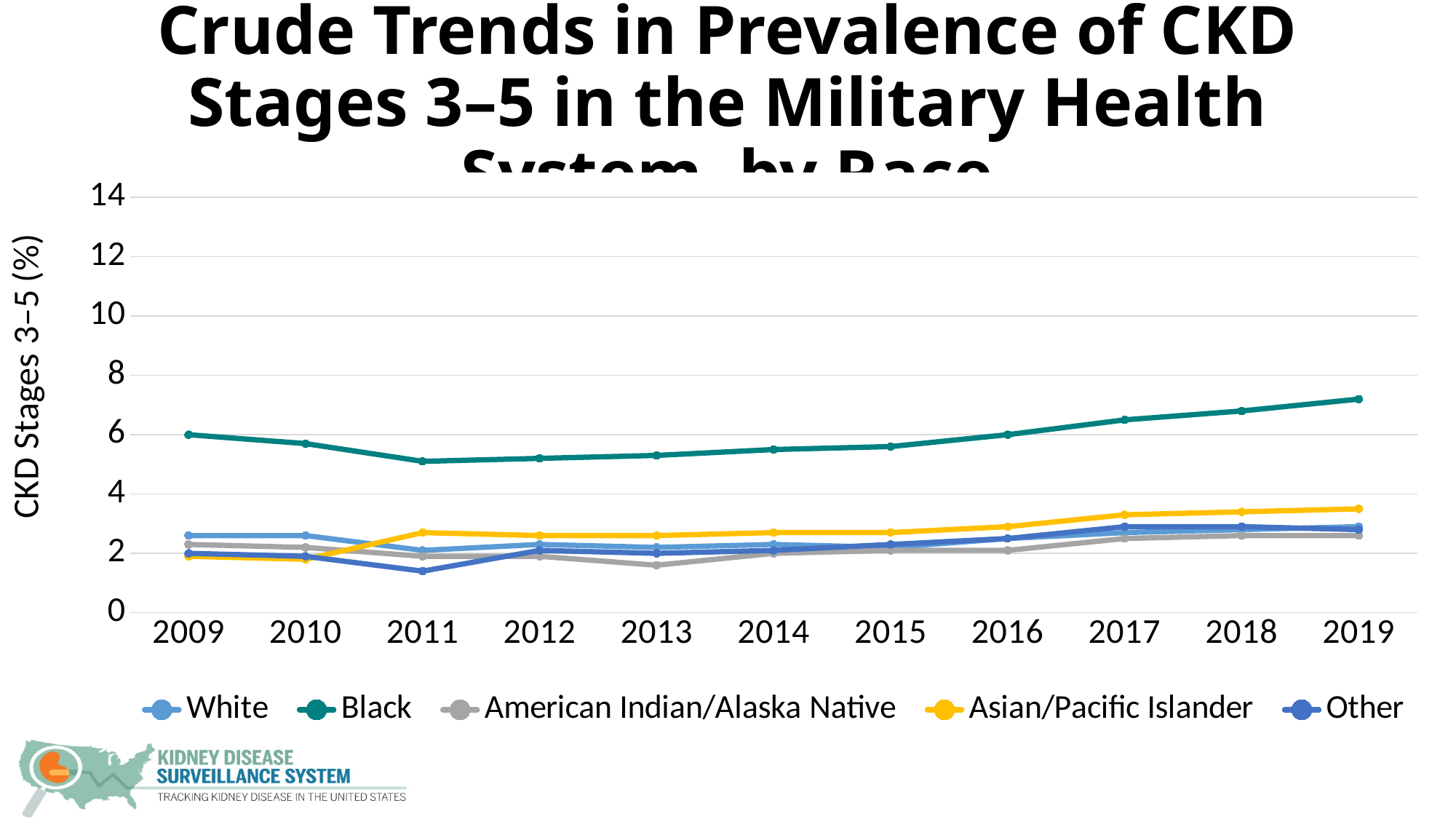
Which race group has the lowest CKD Stages 3–5 prevalence in 2013? American Indian/Alaska Native Is the value for Other in 2011 greater or less than 2? less Which race group has the highest CKD Stages 3–5 prevalence in 2019? Black How many series does the legend list? 5 What kind of chart is shown on the slide? line chart Is the value for Black in 2019 greater or less than 6? greater Which race group has the lowest CKD Stages 3–5 prevalence in 2011? Other Is the value for Black in 2011 greater or less than 6? less Does the prevalence for Black rise or fall from 2011 to 2019? rise Which is larger in 2019, the value for Black or the value for Asian/Pacific Islander? Black How many years are shown on the x axis? 11